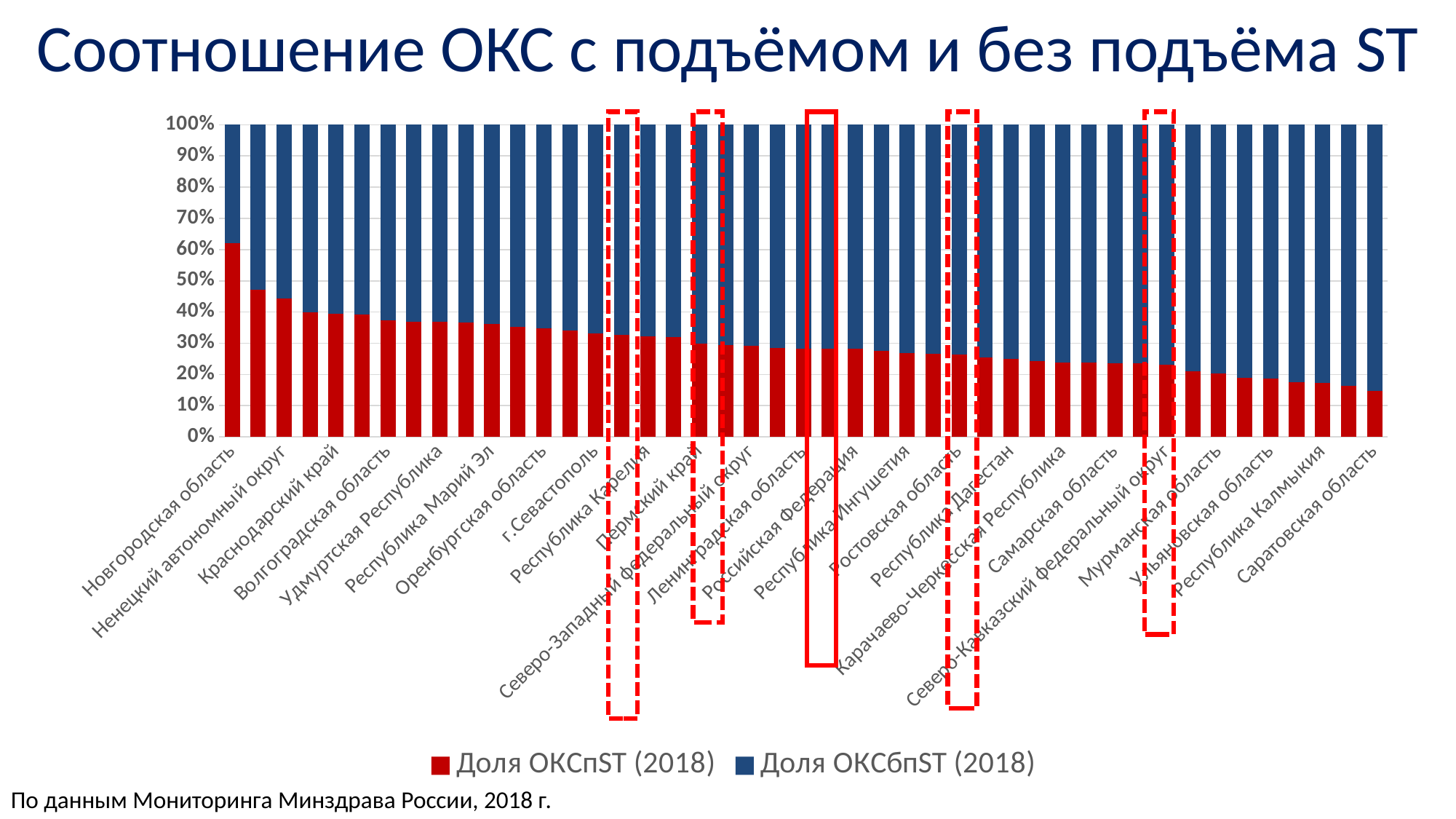
Is the red Доля ОКСпST (2018) share for Новгородская область greater or less than 50%? greater Does the red Доля ОКСпST (2018) share rise or fall moving from left to right along the x axis? fall How many series does the legend list? 2 What does each stacked bar total on the y axis? 100% What is the title of the chart on the slide? Соотношение ОКС с подъёмом и без подъёма ST Which region has the highest share of Доля ОКСпST (2018) (the red segment)? Новгородская область Which colour represents Доля ОКСбпST (2018)? Blue Is the red Доля ОКСпST (2018) share for Саратовская область greater or less than 20%? less Is the red Доля ОКСпST (2018) share for Новгородская область larger or smaller than that for Саратовская область? larger What are the two series named in the legend? Доля ОКСпST (2018) and Доля ОКСбпST (2018) What kind of chart is shown on the slide? Stacked bar chart